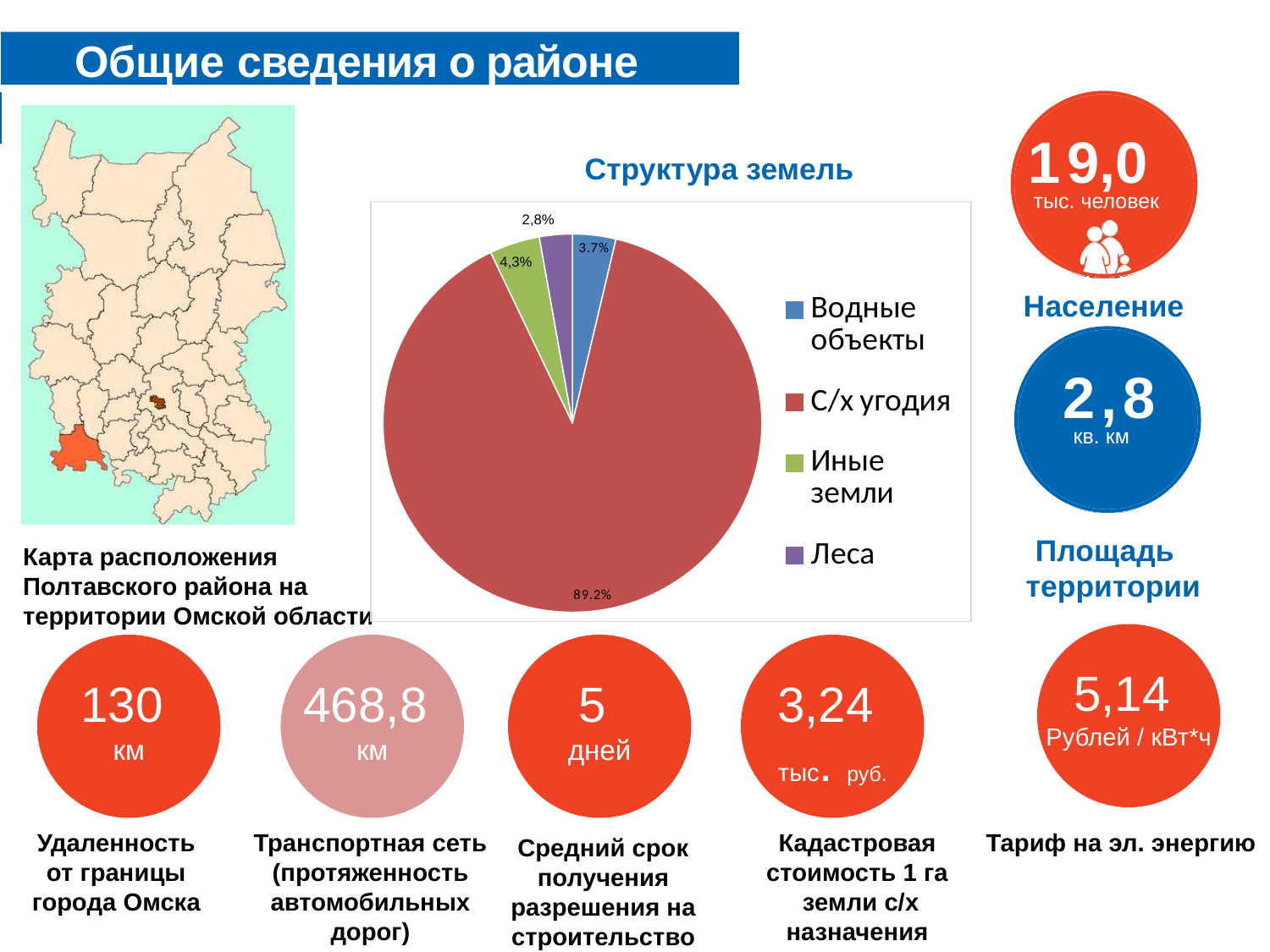
How many categories does the legend of the pie chart list? 4 What share of the pie chart is labelled for "Леса"? 2,8% In the pie chart, what is the difference in percentage points between "Иные земли" and "Леса"? 1,5 What type of chart is shown under the title "Структура земель"? pie chart What is the title of the pie chart on the slide? Структура земель Which category has the largest slice in the pie chart? С/х угодия What share of the pie chart is labelled for "Иные земли"? 4,3% What share of the pie chart is labelled for "С/х угодия"? 89.2% What colour is the "С/х угодия" slice in the pie chart? red Which category has the smallest slice in the pie chart? Леса In the pie chart, which slice is larger: "Иные земли" or "Водные объекты"? Иные земли What share of the pie chart is labelled for "Водные объекты"? 3.7%